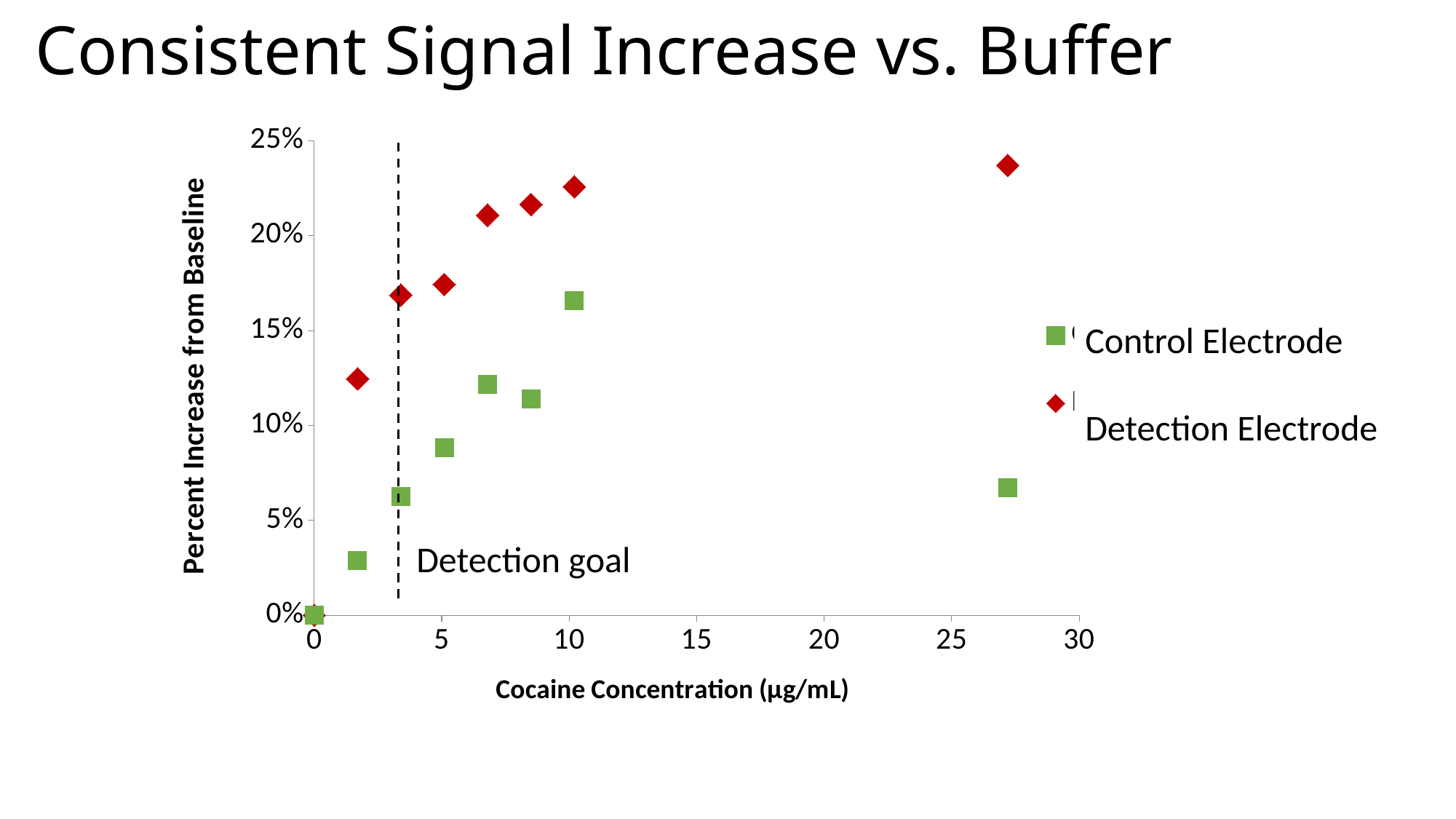
How many data points are plotted for the Detection Electrode series? 8 Which series reaches the highest percent increase from baseline on the chart? Detection Electrode What does the dashed vertical line on the chart represent, according to its label? Detection goal Do the Detection Electrode values generally rise or fall as cocaine concentration increases? rise At about 10 µg/mL cocaine concentration, which series has the higher percent increase from baseline? Detection Electrode What kind of chart is shown on the slide? Scatter chart How many series does the legend list? 2 Is the Control Electrode value at the highest cocaine concentration (around 27 µg/mL) greater or less than 10%? less Is the Detection Electrode value at about 10 µg/mL greater or less than 20%? greater Is the Control Electrode value at about 5 µg/mL greater or less than 10%? less What is the label of the x axis? Cocaine Concentration (µg/mL)